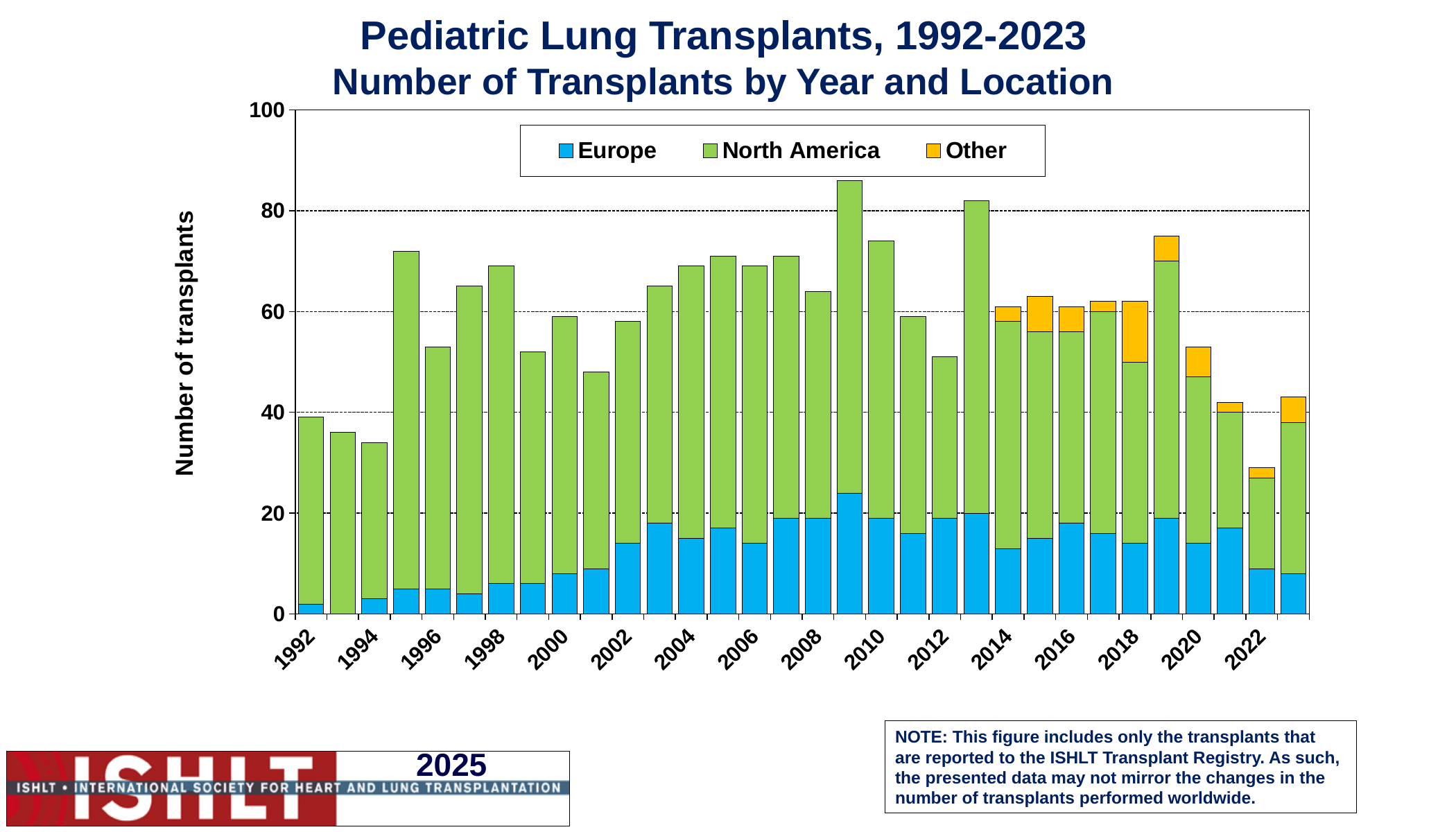
Which year has the highest total number of transplants? 2009 Is the total number of transplants in 1995 greater or less than 60? greater Which year has a larger total number of transplants, 1994 or 1995? 1995 Which year has the lowest total number of transplants? 2022 How many series does the legend list? 3 Which year has a larger total number of transplants, 2019 or 2020? 2019 Is the total number of transplants in 2009 greater or less than 80? greater Is the total number of transplants in 2022 greater or less than 40? less How many years (bars) are plotted on the chart? 32 Which series are listed in the legend? Europe, North America, Other What kind of chart is shown on the slide? Stacked bar chart